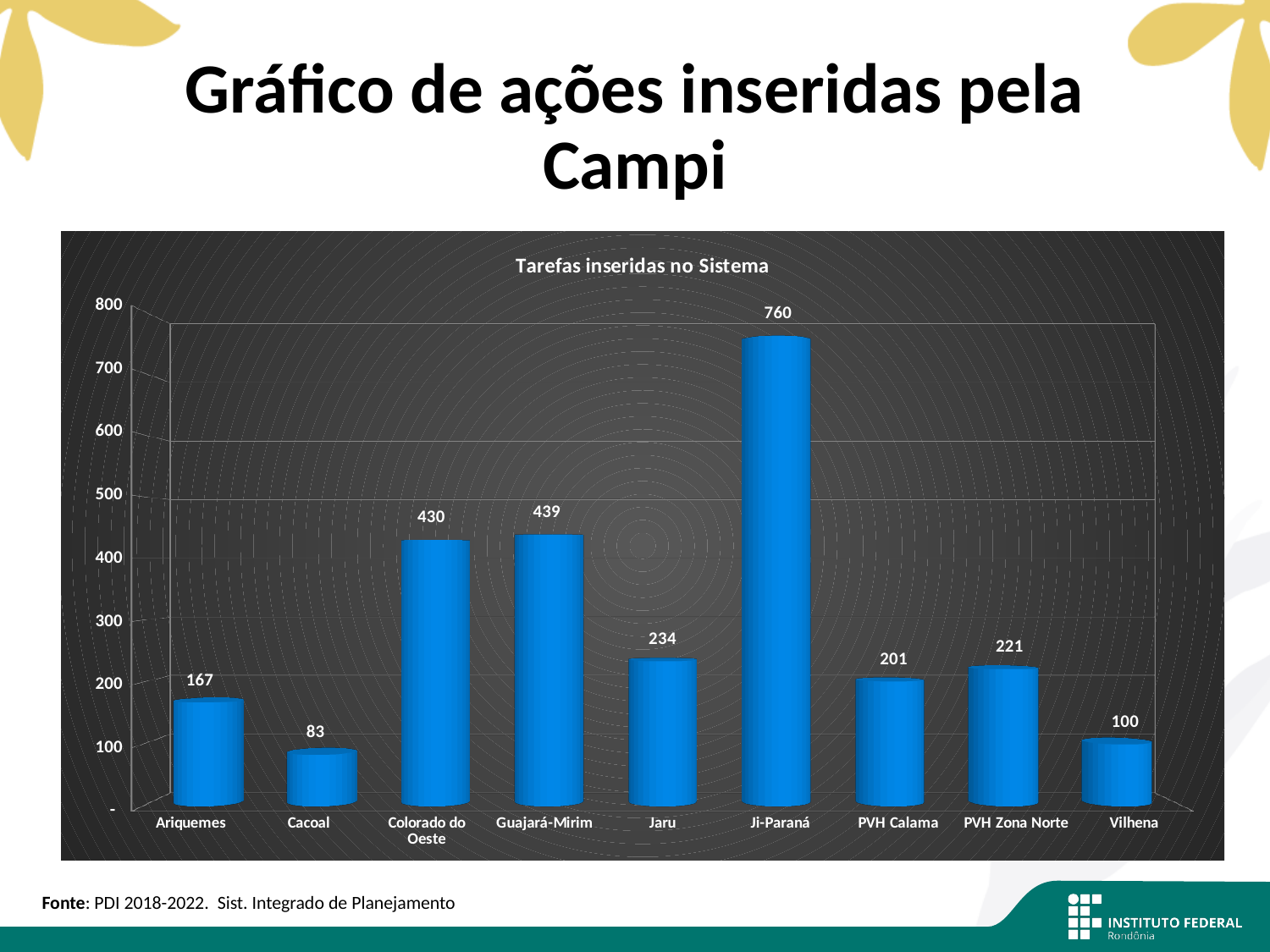
What is the value for Ji-Paraná? 760 What is the difference between the values for Ji-Paraná and Vilhena? 660 Which campus has the highest number of tasks inserted? Ji-Paraná What kind of chart is shown on the slide? bar chart Which campus has the lowest number of tasks inserted? Cacoal What is the title of the chart? Tarefas inseridas no Sistema What is the difference between the values for Guajará-Mirim and Colorado do Oeste? 9 Is the value for Ariquemes greater or less than 200? less What is the value for PVH Zona Norte? 221 What is the value for Cacoal? 83 Which is larger, the value for Jaru or the value for PVH Calama? Jaru How many campuses are shown on the x axis? 9